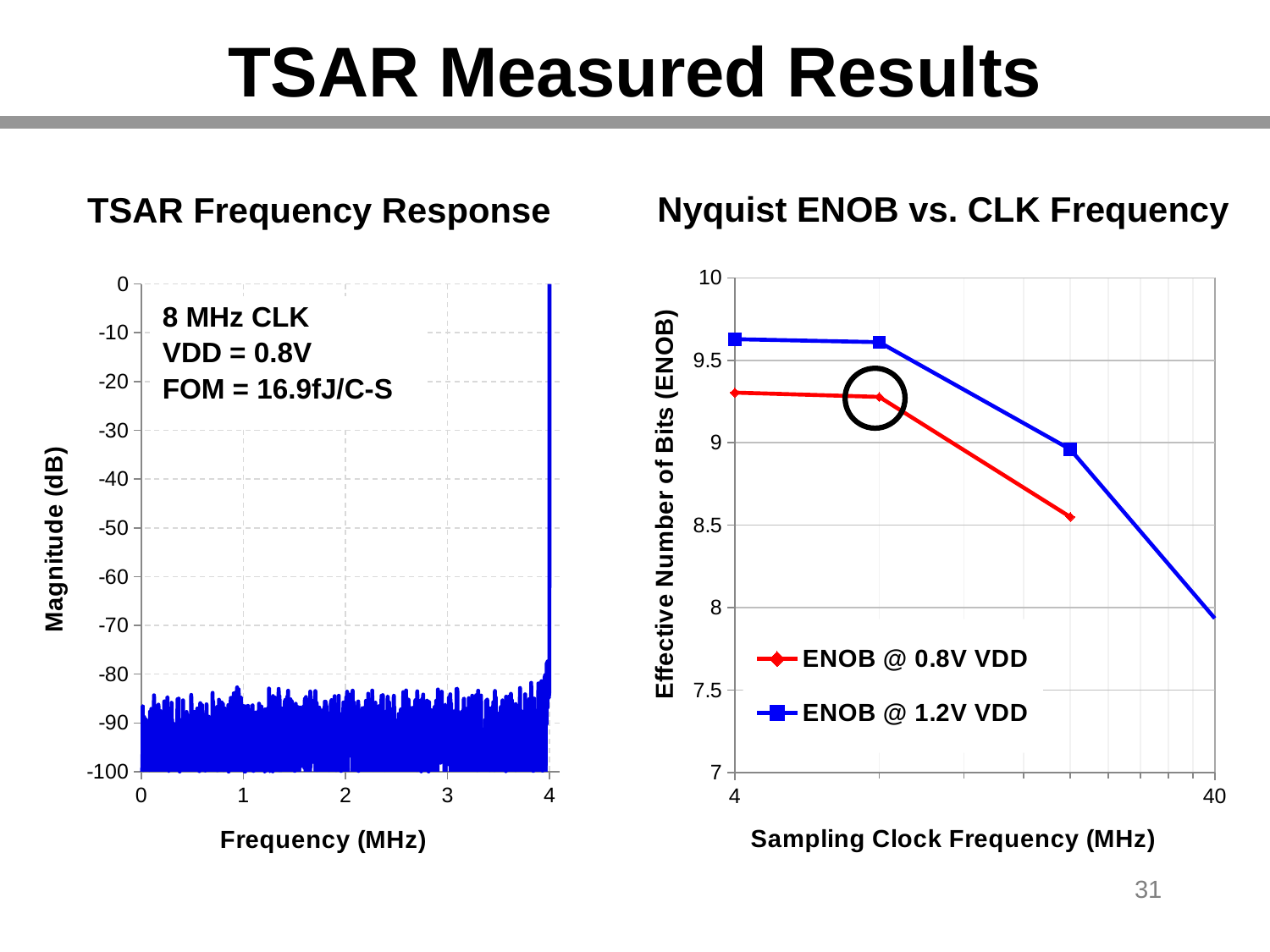
In the 'Nyquist ENOB vs. CLK Frequency' chart, do the ENOB values rise or fall as the sampling clock frequency increases? fall In the 'Nyquist ENOB vs. CLK Frequency' chart, how many data points are plotted for the ENOB @ 1.2V VDD series? 4 In the 'Nyquist ENOB vs. CLK Frequency' chart, which series reaches the highest ENOB value? ENOB @ 1.2V VDD What is the y-axis label of the 'TSAR Frequency Response' chart? Magnitude (dB) What kind of chart is the 'TSAR Frequency Response' chart? line chart In the 'TSAR Frequency Response' chart, is the magnitude of the noise floor at 2 MHz greater or less than -70 dB? less In the 'Nyquist ENOB vs. CLK Frequency' chart, is the ENOB @ 1.2V VDD value at 4 MHz greater or less than 9.5? greater What kind of chart is the 'Nyquist ENOB vs. CLK Frequency' chart? line chart How many series does the legend of the 'Nyquist ENOB vs. CLK Frequency' chart list? 2 In the 'Nyquist ENOB vs. CLK Frequency' chart, how many data points are plotted for the ENOB @ 0.8V VDD series? 3 In the 'Nyquist ENOB vs. CLK Frequency' chart, which series has the higher ENOB at 4 MHz, ENOB @ 0.8V VDD or ENOB @ 1.2V VDD? ENOB @ 1.2V VDD In the 'Nyquist ENOB vs. CLK Frequency' chart, is the ENOB @ 0.8V VDD value at 4 MHz greater or less than 9.5? less